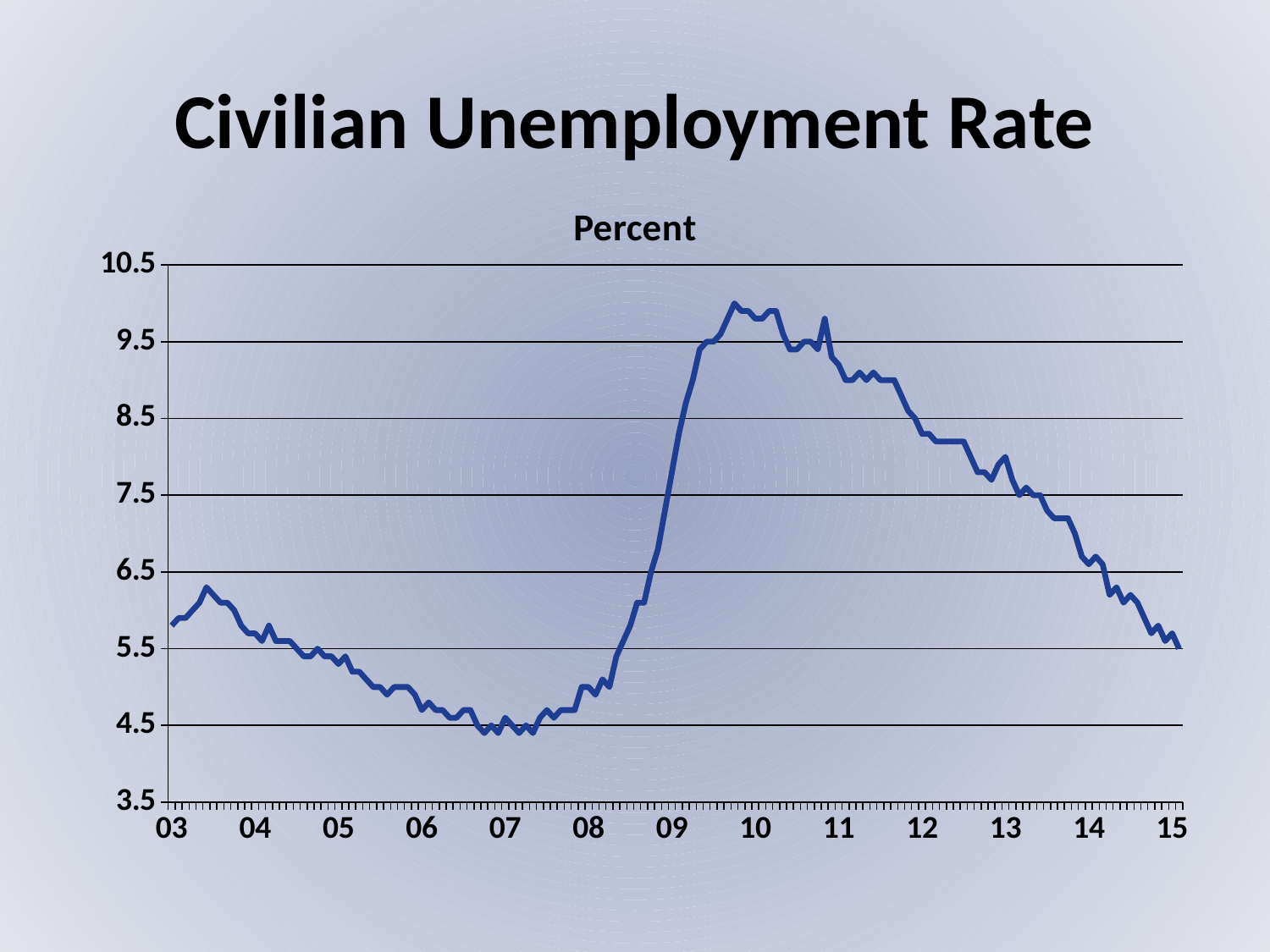
Is the highest point on the line greater or less than 9.5? greater Does the unemployment rate rise or fall between 11 and 15? fall What is the title of the chart? Civilian Unemployment Rate Does the unemployment rate rise or fall between 03 and 07? fall Is the unemployment rate at the start of 10 greater or less than 9.5? greater Is the unemployment rate at the start of 12 greater or less than 7.5? greater What kind of chart is shown on the slide? line chart What unit label is shown above the chart's vertical axis? Percent Which is higher, the unemployment rate at the start of 10 or at the start of 07? 10 Does the unemployment rate rise or fall between 09 and 10? rise